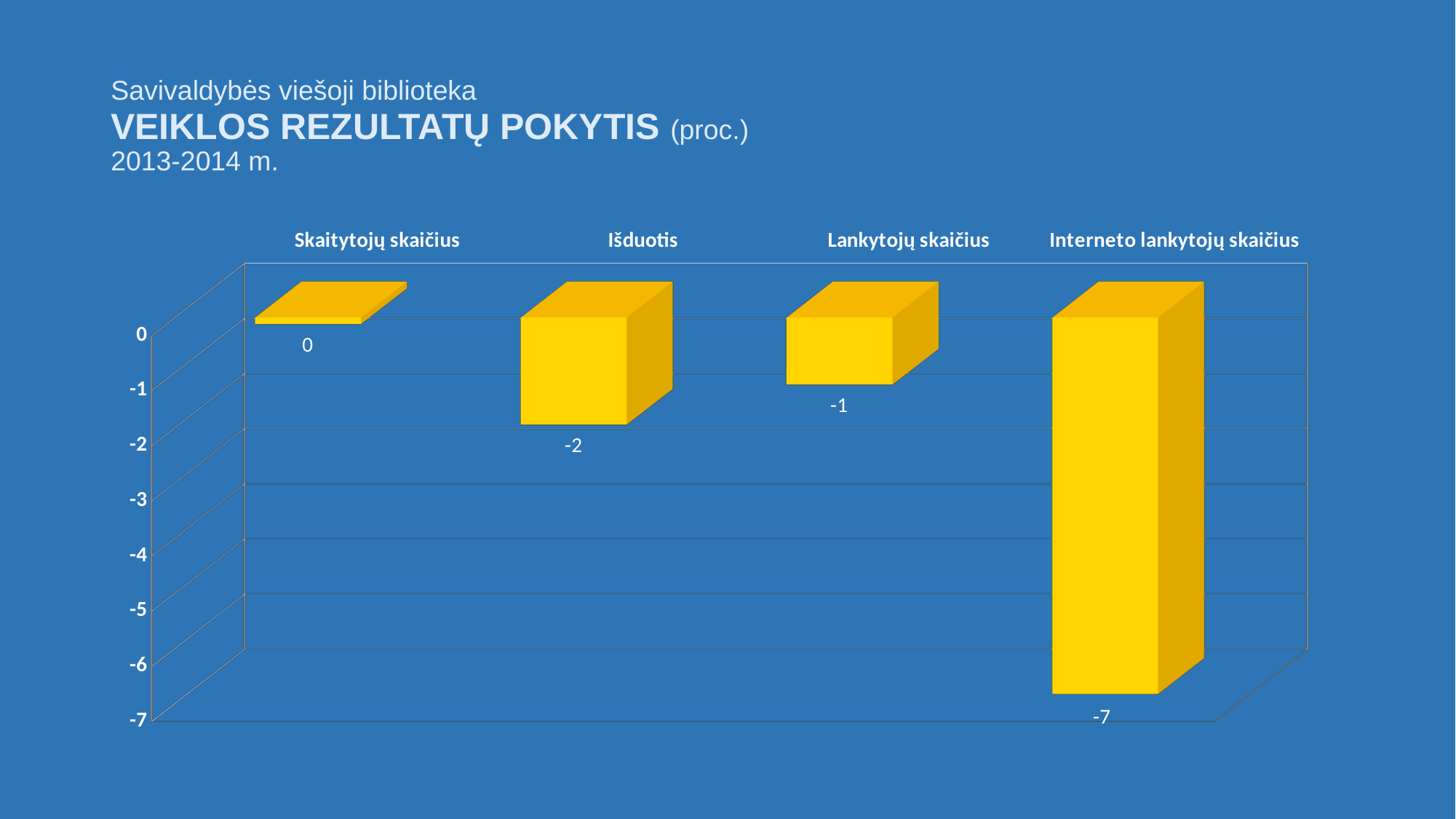
What is the lowest value shown on the vertical axis? -7 Which category has the highest value? Skaitytojų skaičius What is the value for Išduotis? -2 What is the difference between the values for Išduotis and Interneto lankytojų skaičius? 5 How many categories are shown in the chart? 4 Which category has the lowest value? Interneto lankytojų skaičius What kind of chart is shown on the slide? Bar chart What is the value for Skaitytojų skaičius? 0 What is the value for Lankytojų skaičius? -1 What is the value for Interneto lankytojų skaičius? -7 What colour are the bars in the chart? Yellow Which is larger, the value for Išduotis or the value for Lankytojų skaičius? Lankytojų skaičius